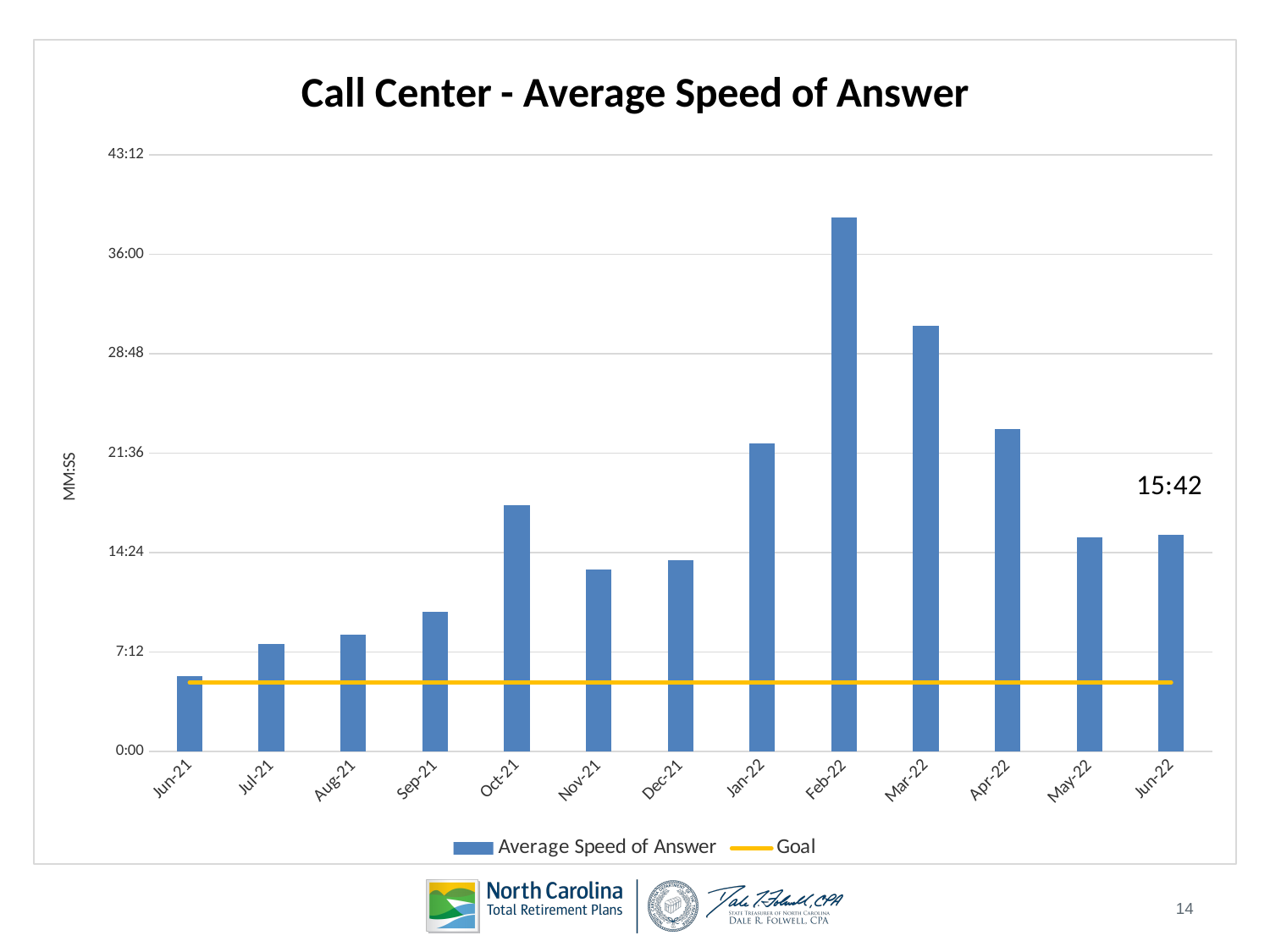
How many months are shown on the x axis of the chart? 13 What is the data label shown for Jun-22? 15:42 Is the Average Speed of Answer for Feb-22 greater or less than 36:00? greater What is the title of the chart? Call Center - Average Speed of Answer What type of chart is shown on the slide? bar chart Is the Average Speed of Answer for Nov-21 greater or less than 14:24? less Do the Average Speed of Answer values rise or fall from Feb-22 to May-22? fall Which month has the lowest Average Speed of Answer? Jun-21 Is the Average Speed of Answer for Mar-22 greater or less than 28:48? greater Which month has the highest Average Speed of Answer? Feb-22 How many series does the legend list? 2 Which month has a higher Average Speed of Answer, Dec-21 or Jan-22? Jan-22